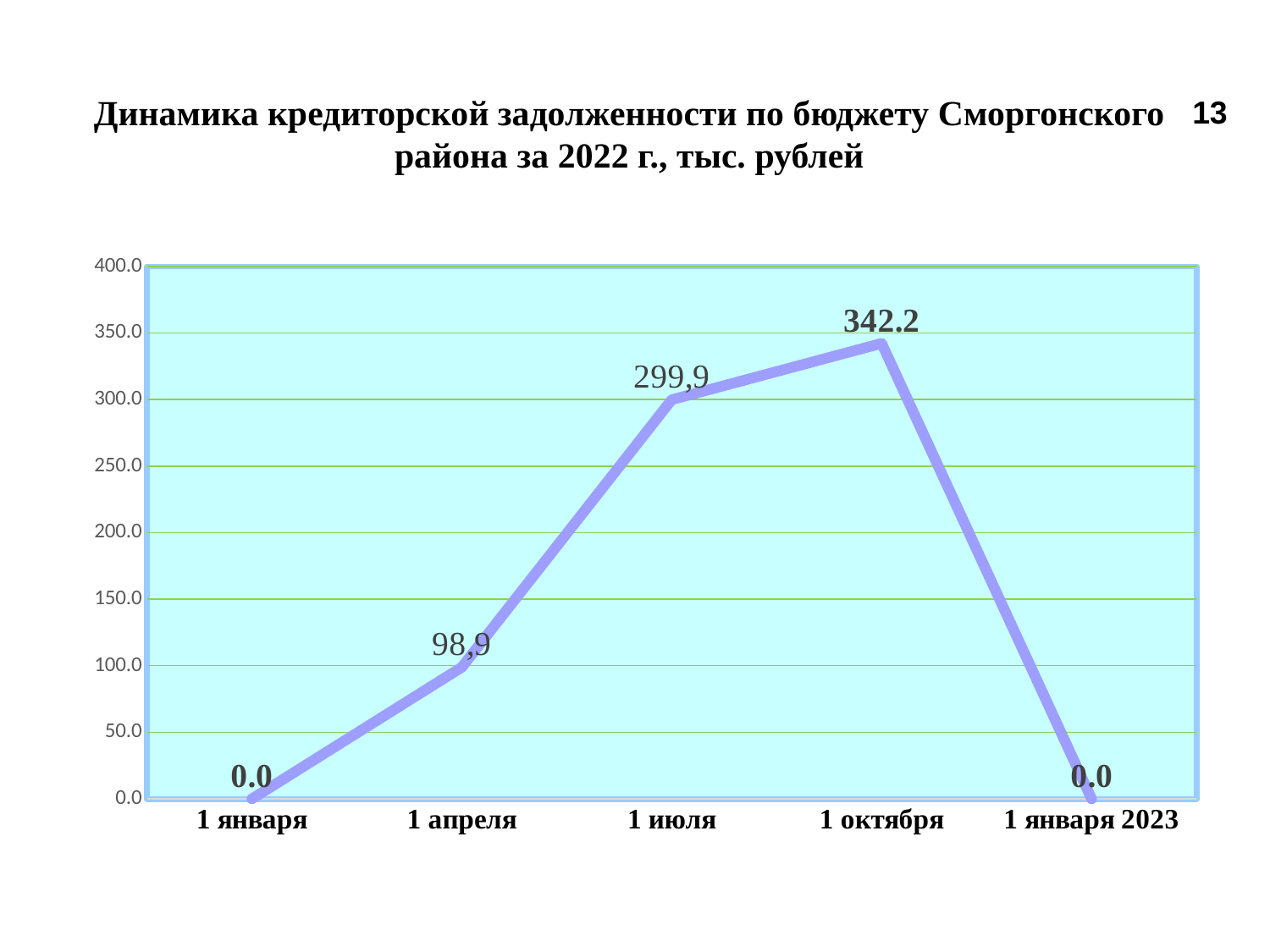
Does the value rise or fall from 1 января to 1 октября? rise Which date has the highest value? 1 октября What is the title of the chart? Динамика кредиторской задолженности по бюджету Сморгонского района за 2022 г., тыс. рублей What is the difference between the values for 1 октября and 1 июля? 42.3 Which is larger, the value for 1 июля or the value for 1 апреля? 1 июля What is the value for 1 июля? 299,9 How many data points are plotted on the chart? 5 Is the value for 1 октября greater or less than 300? greater What is the value for 1 октября? 342.2 What is the value for 1 января 2023? 0.0 What type of chart is shown on the slide? line chart What is the value for 1 апреля? 98,9